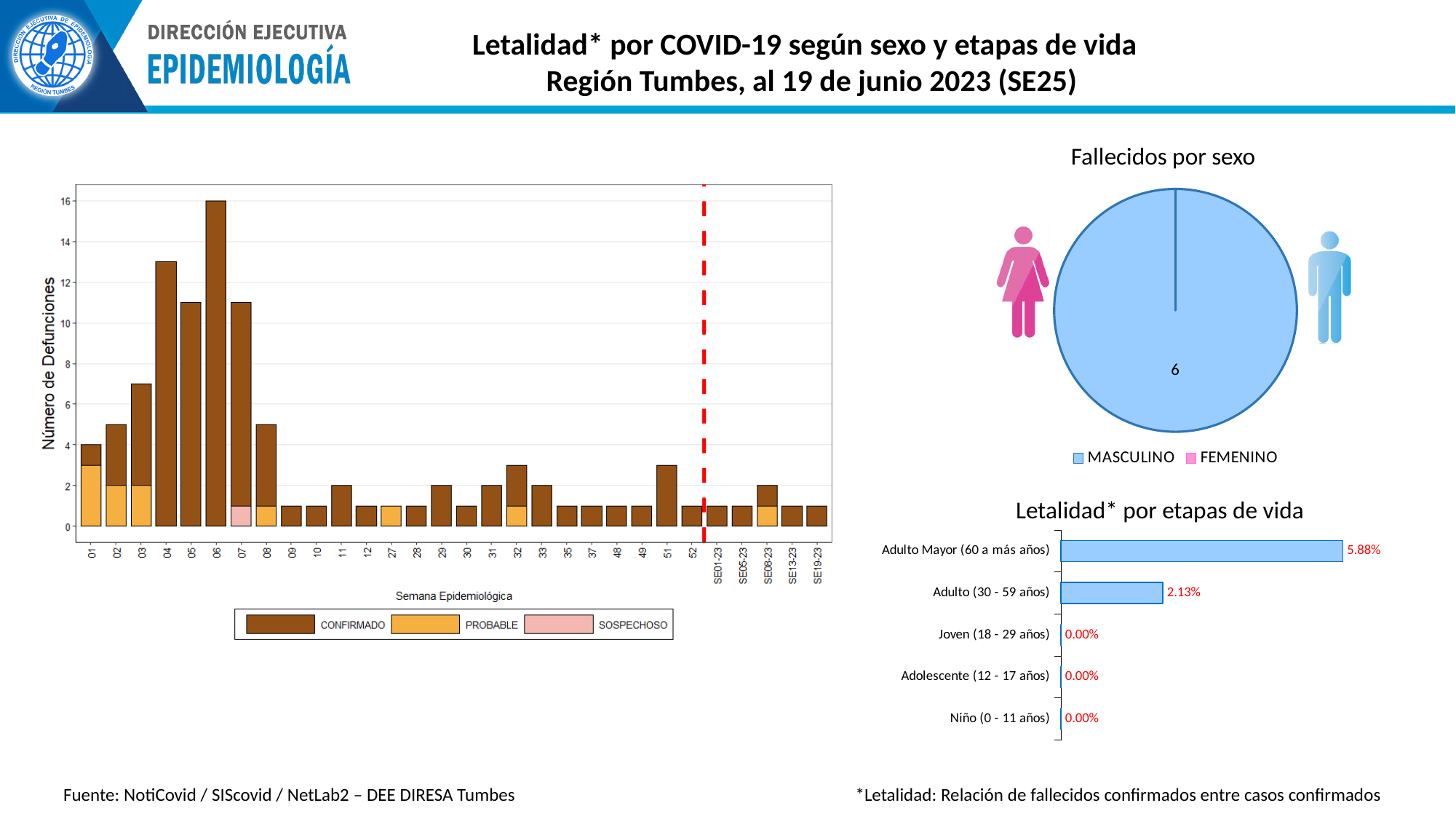
In the 'Letalidad* por etapas de vida' chart, what is the value for Adulto (30 - 59 años)? 2.13% In the stacked bar chart of deaths by epidemiological week (left), is the total for week 04 greater or less than 12? greater In the 'Letalidad* por etapas de vida' chart, what is the difference between the values for Adulto Mayor (60 a más años) and Adulto (30 - 59 años)? 3.75% In the 'Letalidad* por etapas de vida' chart, what is the value for Joven (18 - 29 años)? 0.00% In the 'Letalidad* por etapas de vida' chart, which age group has the highest value? Adulto Mayor (60 a más años) In the 'Letalidad* por etapas de vida' chart, what is the value for Adulto Mayor (60 a más años)? 5.88% In the 'Fallecidos por sexo' pie chart, what value is printed on the MASCULINO slice? 6 In the stacked bar chart of deaths by epidemiological week (left), how many series does the legend list? 3 In the 'Fallecidos por sexo' pie chart, how many categories does the legend list? 2 In the stacked bar chart of deaths by epidemiological week (left), which week has the highest total number of deaths? 06 In the 'Letalidad* por etapas de vida' chart, how many age groups are shown? 5 In the 'Fallecidos por sexo' pie chart, which category makes up the entire pie? MASCULINO